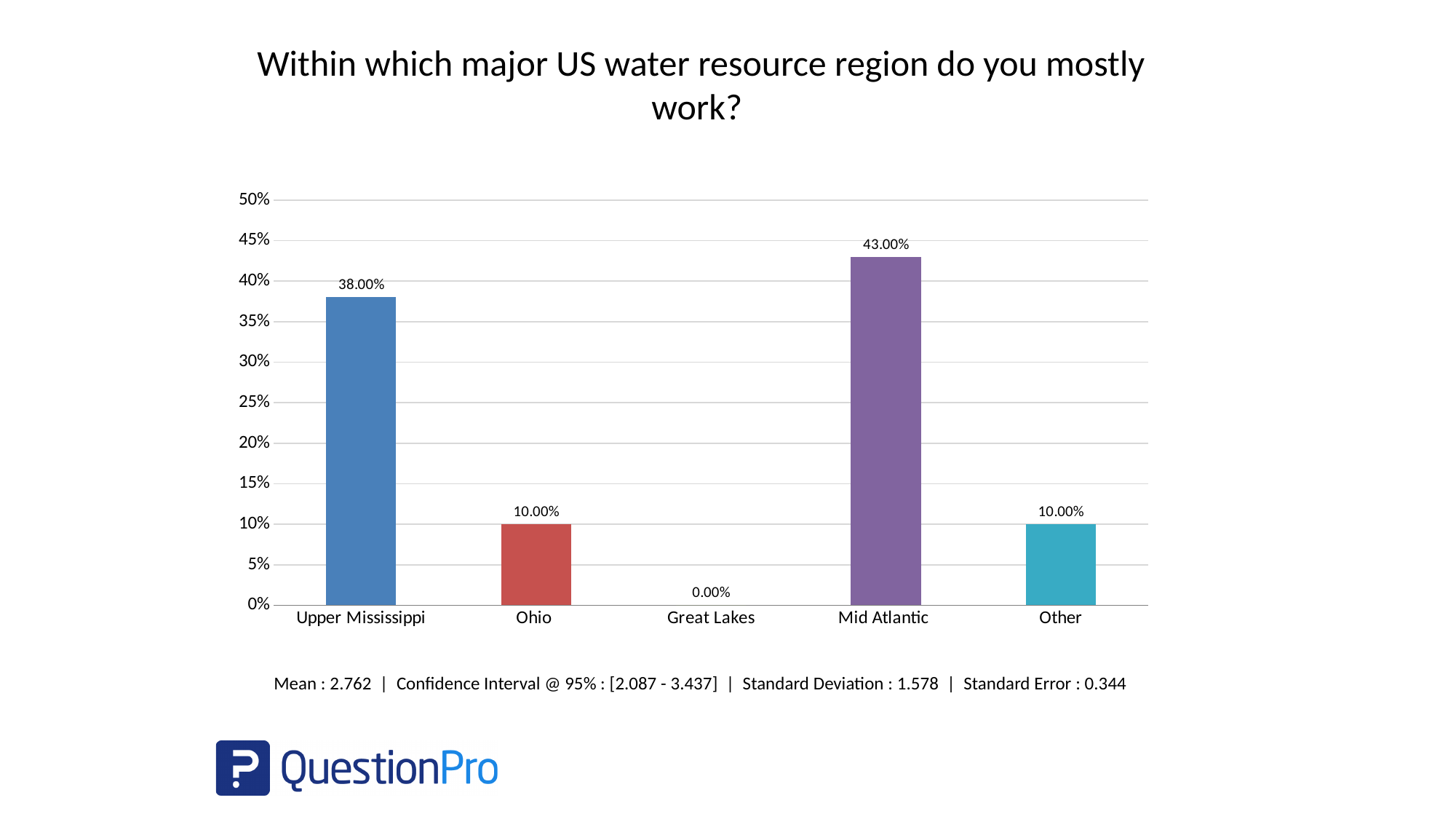
What is the difference between the values for Upper Mississippi and Ohio? 28.00% Which region has the lowest value? Great Lakes What is the title of the chart? Within which major US water resource region do you mostly work? How many regions are shown on the x axis? 5 What is the value for Mid Atlantic? 43.00% What kind of chart is shown on the slide? Bar chart Which region has the highest value? Mid Atlantic What is the value for Upper Mississippi? 38.00% What is the value for Great Lakes? 0.00% What is the difference between the values for Mid Atlantic and Upper Mississippi? 5.00% Which is larger, the value for Upper Mississippi or the value for Mid Atlantic? Mid Atlantic What is the value for Ohio? 10.00%